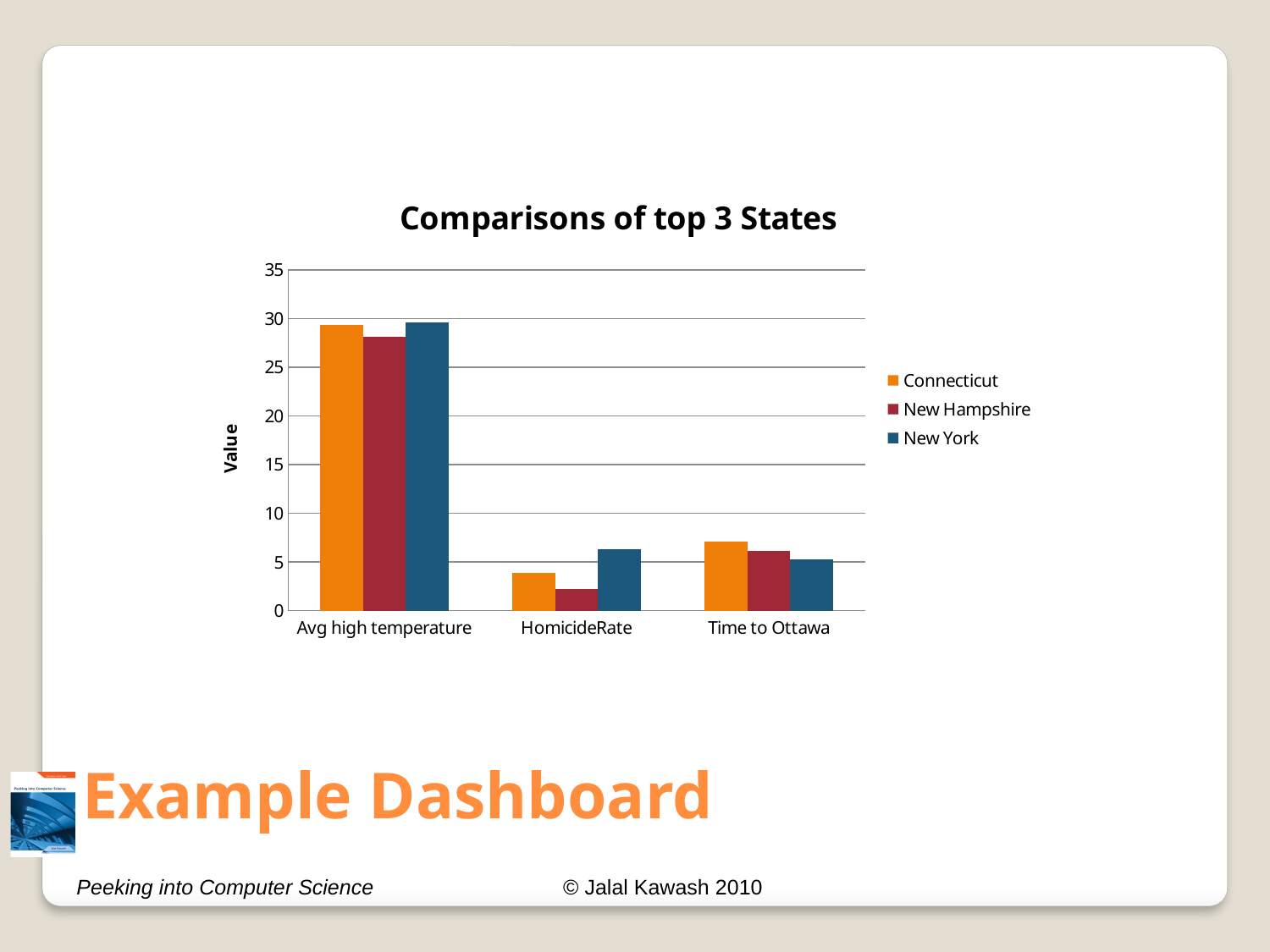
Is the value for Connecticut in Avg high temperature greater or less than 25? greater How many series does the legend list? 3 Which state has the highest value for Time to Ottawa? Connecticut What is the title of the chart? Comparisons of top 3 States Which state has the lowest value for Avg high temperature? New Hampshire Is the value for New York in HomicideRate greater or less than 5? greater Is the value for New Hampshire in HomicideRate greater or less than 5? less How many categories are shown on the x axis? 3 For Time to Ottawa, which is larger: the value for Connecticut or the value for New York? Connecticut What kind of chart is shown on the slide? bar chart Which state has the lowest value for HomicideRate? New Hampshire Which state has the highest value for HomicideRate? New York